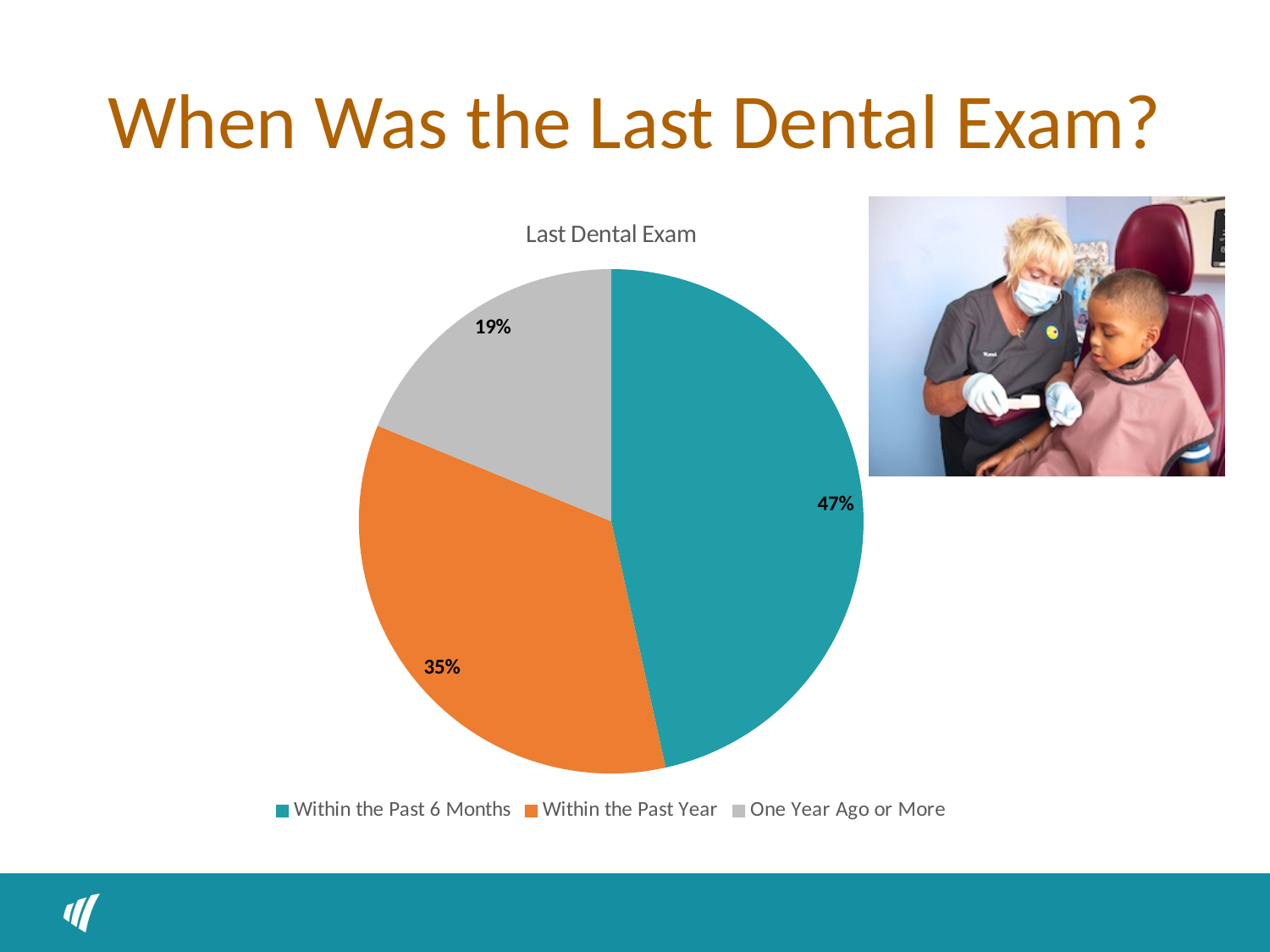
What type of chart is shown on the slide? Pie chart Which is larger: the share for 'Within the Past Year' or 'One Year Ago or More'? Within the Past Year What colour is the slice for 'Within the Past Year'? Orange What percentage of respondents had their last dental exam within the past year? 35% Which category has the largest share of the pie? Within the Past 6 Months What is the difference in percentage points between 'Within the Past 6 Months' and 'One Year Ago or More'? 28 What is the title of the chart? Last Dental Exam Which category has the smallest share of the pie? One Year Ago or More What percentage of respondents had their last dental exam within the past 6 months? 47% What is the difference in percentage points between 'Within the Past 6 Months' and 'Within the Past Year'? 12 What percentage of respondents had their last dental exam one year ago or more? 19% How many categories does the pie chart have? 3